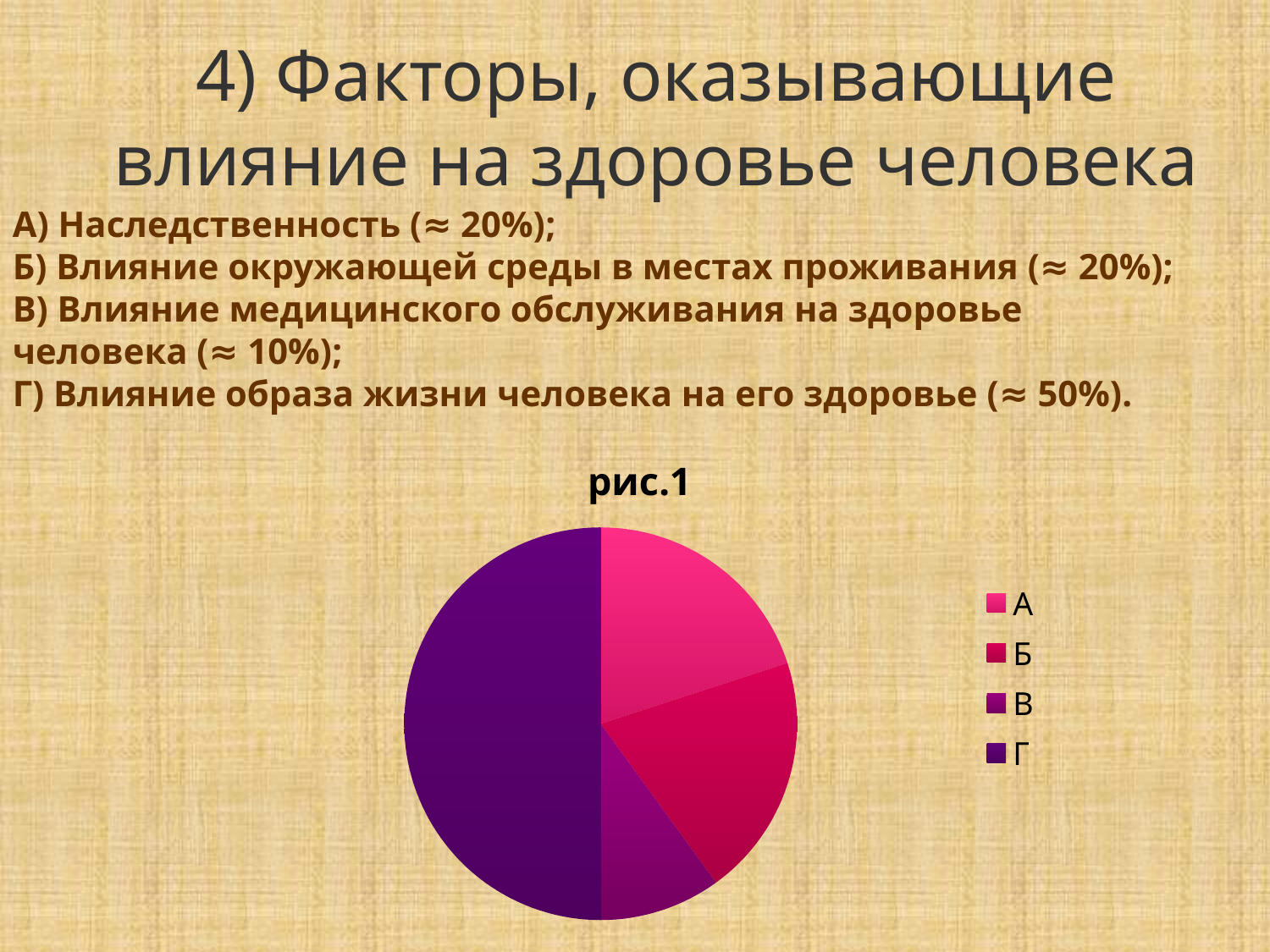
Which slice is larger, Г or А? Г How many entries does the chart legend list? 4 Which category is shown in dark purple in the legend? Г What kind of chart is shown on the slide? pie chart How many slices does the pie chart have? 4 Which slice is larger, А or В? А What is the title of the chart? рис.1 Which slice is larger, Б or В? Б Which category has the smallest slice of the pie? В Which category has the largest slice of the pie? Г